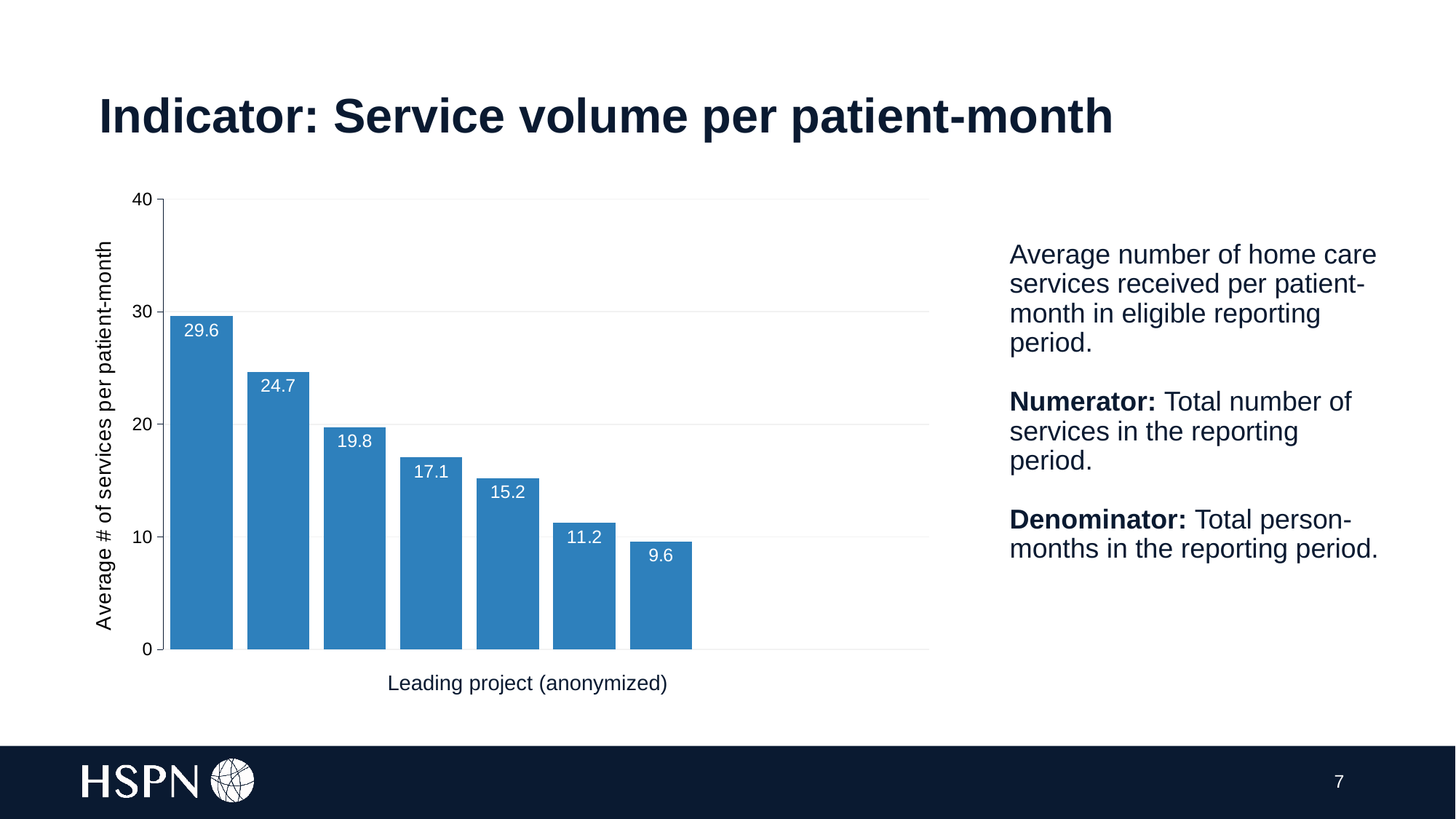
What is the difference between the first bar (29.6) and the last bar (9.6)? 20 What is the value shown on the fifth bar from the left? 15.2 Which is larger, the value of the second bar or the value of the third bar? The second bar (24.7) What is the value shown on the third bar from the left? 19.8 What is the value of the tallest bar in the chart? 29.6 What kind of chart is shown on the slide? Bar chart Do the bar values rise or fall from left to right along the x axis? Fall What is the difference between the fourth bar (17.1) and the sixth bar (11.2)? 5.9 What is the value of the shortest bar in the chart? 9.6 Is the value of the first bar greater or less than 30? less How many bars are plotted in the chart? 7 What is the value shown on the second bar from the left? 24.7